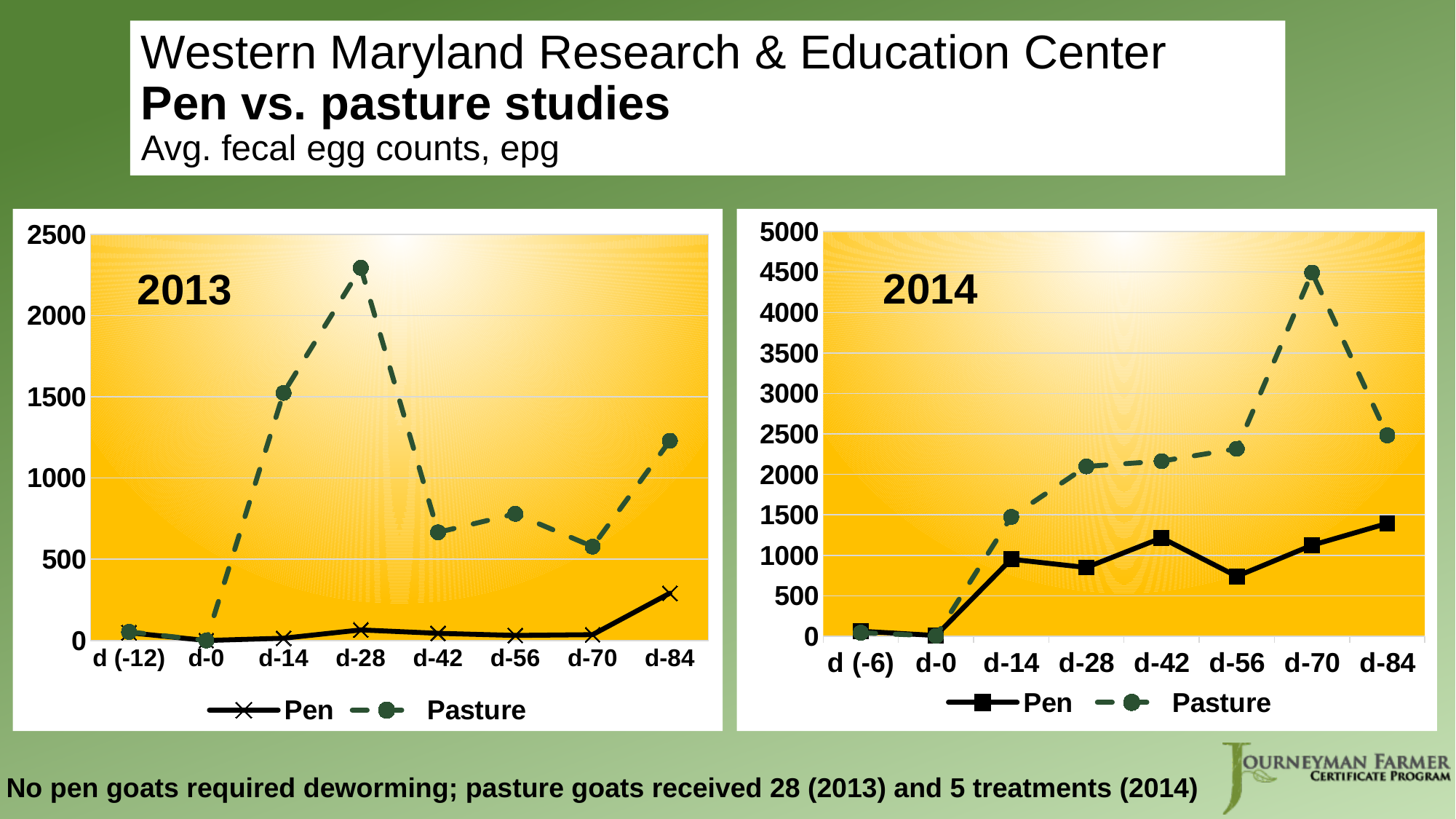
In the 2014 chart, at which day does the Pen series reach its highest value? d-84 In the 2013 chart, at which day does the Pasture series reach its highest value? d-28 How many series does the legend of the 2013 chart list? 2 In the 2014 chart, does the Pen series generally rise or fall from d-0 to d-84? rise How many day points are plotted on the x axis of the 2014 chart? 8 What kind of chart is the 2013 chart? line chart In the 2014 chart, is the Pen value at d-56 greater or less than 500? greater In the 2013 chart, is the Pasture value at d-28 greater or less than 2000? greater In the 2013 chart, which series has the larger value at d-28, Pen or Pasture? Pasture In the 2014 chart, at which day does the Pasture series reach its highest value? d-70 In the 2014 chart, is the Pasture value at d-70 greater or less than 4000? greater